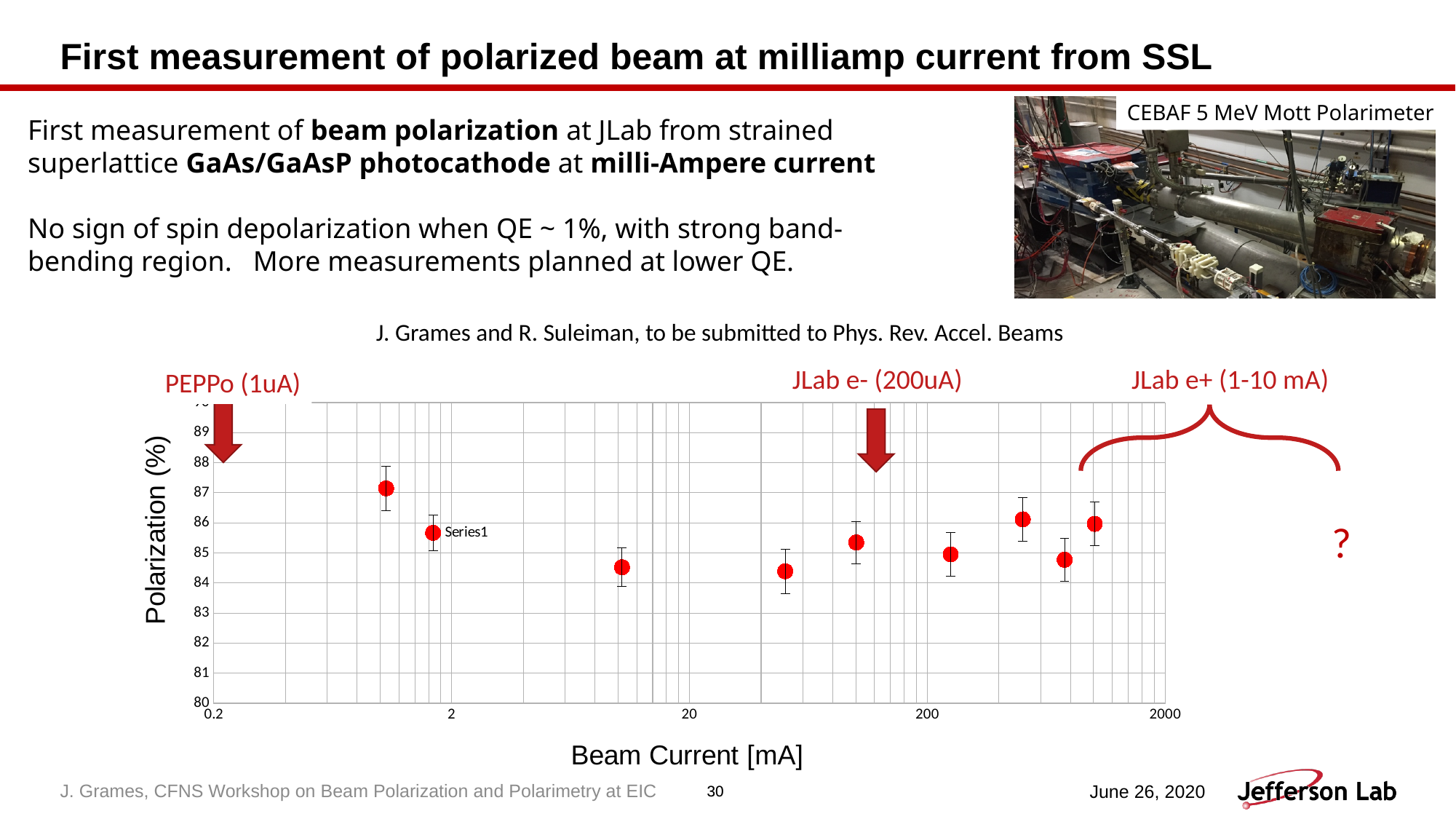
How many data points are plotted in the chart? 9 How many data series are plotted in the chart? 1 Which data point has the highest polarization: the leftmost point or the rightmost point? the leftmost point Do the polarization values show a clear rising or falling trend as beam current increases? No clear trend What is the lowest tick value shown on the y-axis? 80 What is the largest tick value shown on the x-axis? 2000 What is the x-axis title of the chart? Beam Current [mA] What kind of chart is shown on the slide? Scatter plot Are all plotted polarization values greater or less than 80? greater What is the y-axis title of the chart? Polarization (%) Is the polarization value of the leftmost data point greater or less than 86? greater Is the polarization value of the data point near 8 mA greater or less than 85? less